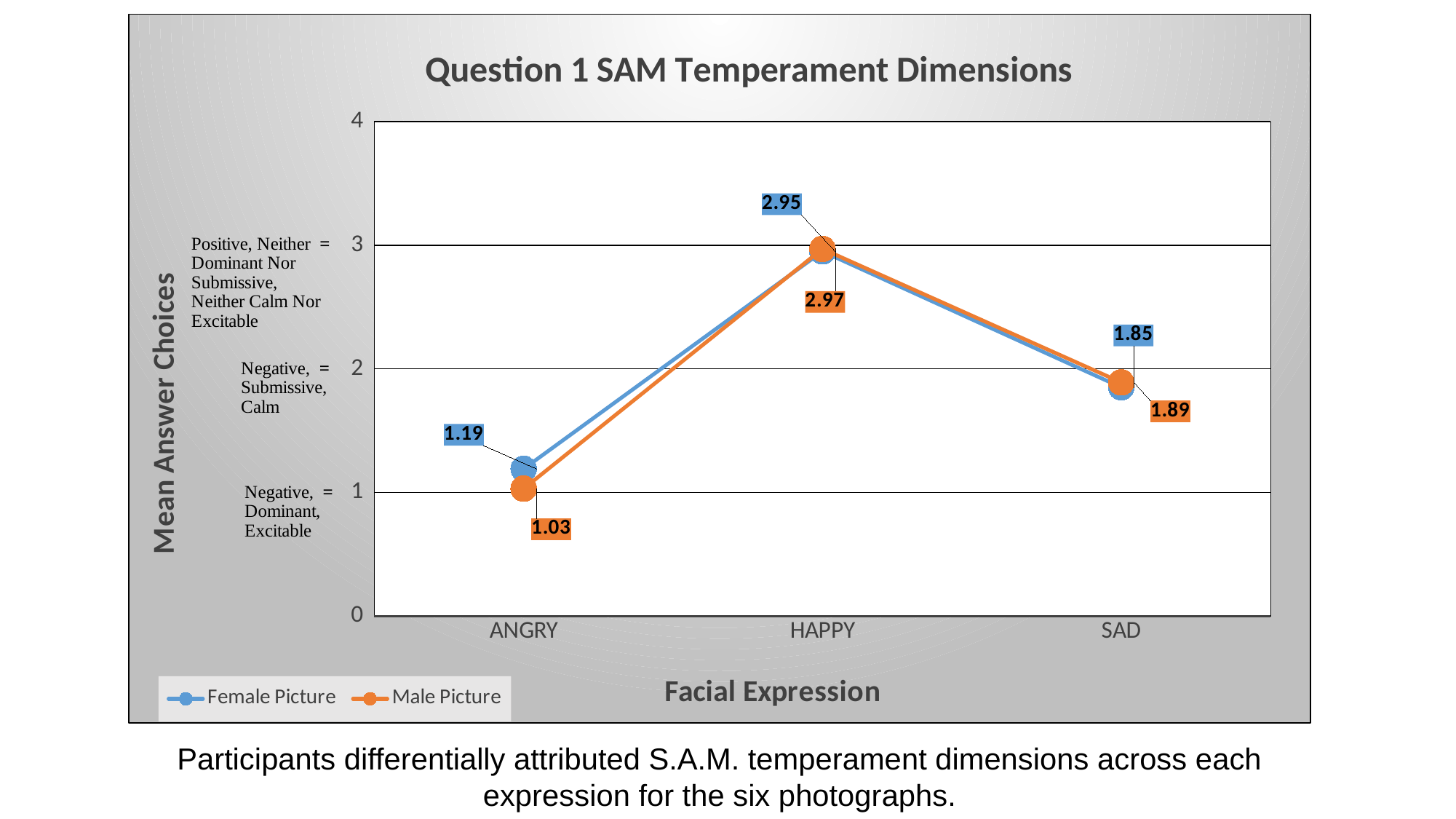
What is the difference between the Male Picture values at HAPPY and SAD? 1.08 Which facial expression has the lowest value for Female Picture? ANGRY What is the value for Female Picture at ANGRY? 1.19 What kind of chart is this? Line chart What is the value for Female Picture at SAD? 1.85 What is the difference between the Female Picture and Male Picture values at ANGRY? 0.16 How many facial expression categories are shown on the x axis? 3 What is the value for Male Picture at SAD? 1.89 What is the value for Male Picture at HAPPY? 2.97 How many series does the legend list? 2 What is the title of the chart? Question 1 SAM Temperament Dimensions Which facial expression has the highest value for Male Picture? HAPPY